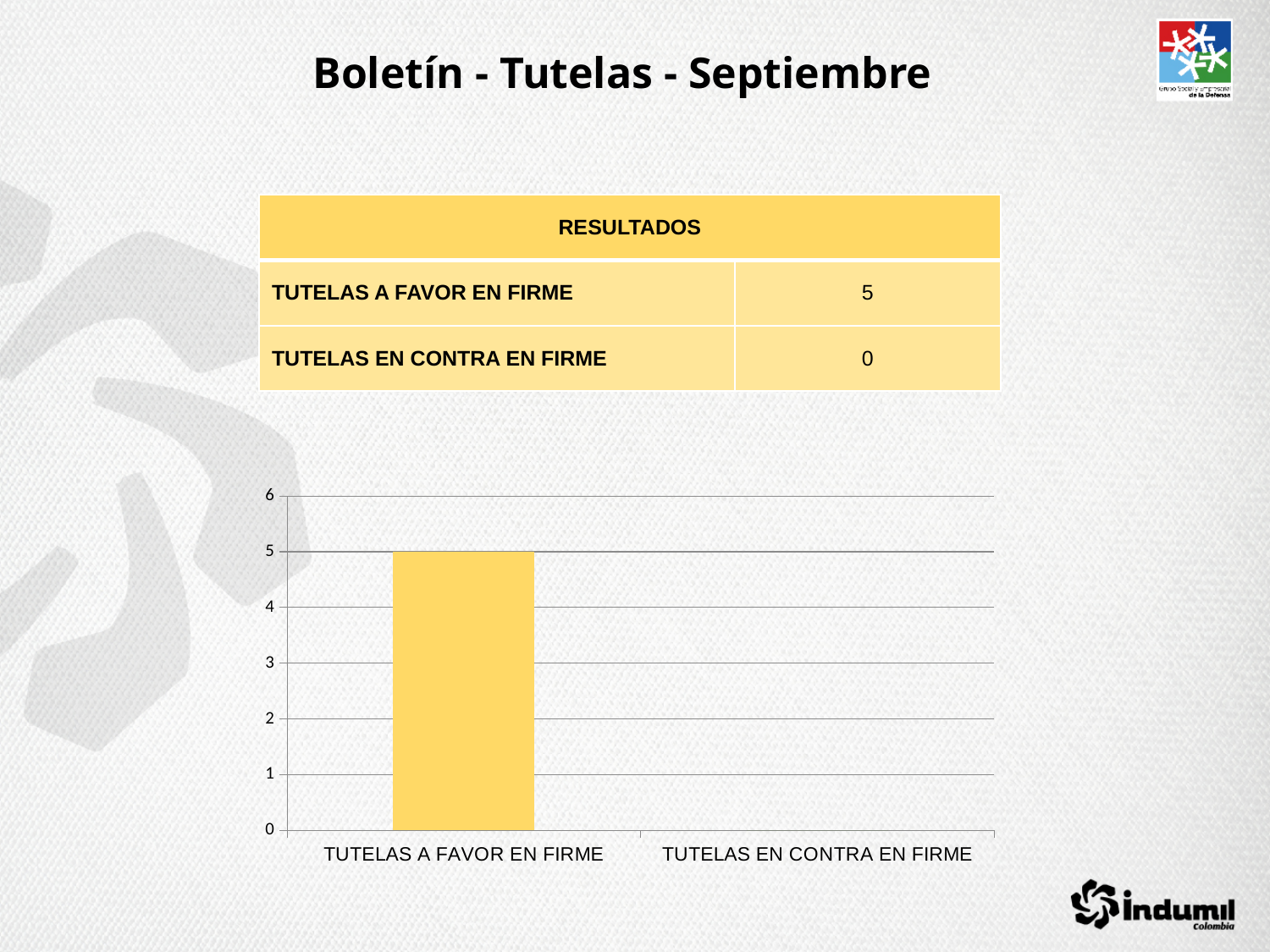
What is the value for TUTELAS A FAVOR EN FIRME in the chart? 5 What is the highest value shown on the chart's vertical axis? 6 Which category has the highest value in the chart? TUTELAS A FAVOR EN FIRME What kind of chart is shown on the slide? bar chart What is the value for TUTELAS EN CONTRA EN FIRME in the chart? 0 What colour is the bar in the chart? yellow Which category has the lowest value in the chart? TUTELAS EN CONTRA EN FIRME Is the value for TUTELAS A FAVOR EN FIRME greater or less than 3? greater Which is larger, the value for TUTELAS A FAVOR EN FIRME or the value for TUTELAS EN CONTRA EN FIRME? TUTELAS A FAVOR EN FIRME Do the values rise or fall from left to right along the x axis of the chart? fall How many categories are shown on the x axis of the chart? 2 What is the difference between the values for TUTELAS A FAVOR EN FIRME and TUTELAS EN CONTRA EN FIRME? 5